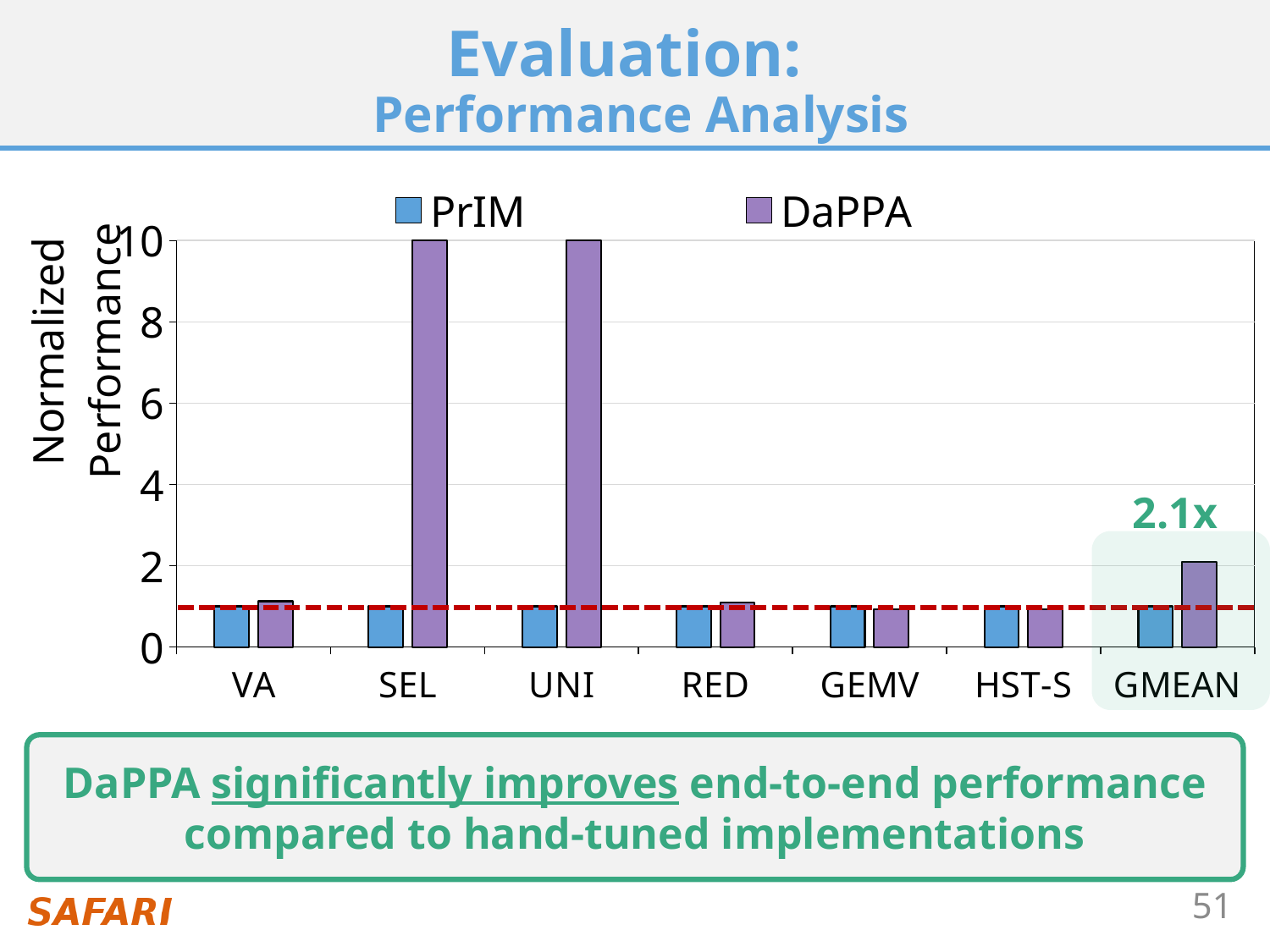
Is the PrIM value for RED greater or less than 2? less How many categories are shown on the x axis? 7 What value is labelled above the GMEAN bars for DaPPA? 2.1x Which is larger, the DaPPA value for UNI or the DaPPA value for GMEAN? UNI What kind of chart is shown on the slide? bar chart Is the DaPPA value for SEL greater or less than 8? greater Is the DaPPA value for VA greater or less than 2? less What is the label on the y axis? Normalized Performance How many series does the legend list? 2 Which is larger, the DaPPA value for SEL or the DaPPA value for RED? SEL What are the two series named in the legend? PrIM and DaPPA